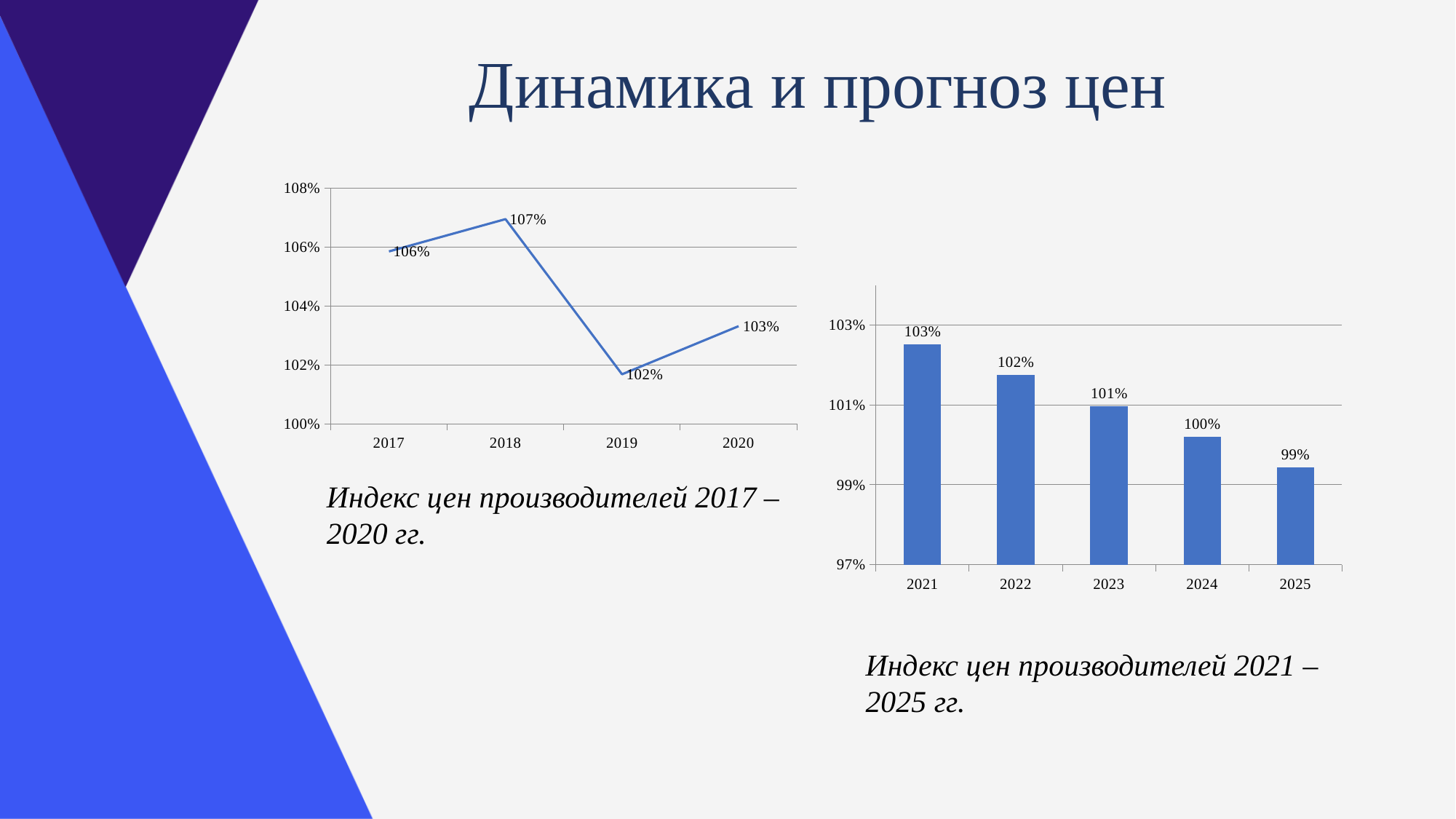
In the left chart (Индекс цен производителей 2017 – 2020 гг.), how many years are plotted? 4 In the left chart (Индекс цен производителей 2017 – 2020 гг.), what is the value for 2018? 107% In the left chart (Индекс цен производителей 2017 – 2020 гг.), which year has the lowest value? 2019 In the right chart (Индекс цен производителей 2021 – 2025 гг.), how many bars are there? 5 In the left chart (Индекс цен производителей 2017 – 2020 гг.), which year has the highest value? 2018 In the right chart (Индекс цен производителей 2021 – 2025 гг.), what kind of chart is shown? bar chart In the left chart (Индекс цен производителей 2017 – 2020 гг.), what is the value for 2019? 102% In the right chart (Индекс цен производителей 2021 – 2025 гг.), which year has the highest value? 2021 In the right chart (Индекс цен производителей 2021 – 2025 гг.), what is the value for 2023? 101% In the right chart (Индекс цен производителей 2021 – 2025 гг.), what is the value for 2025? 99% In the right chart (Индекс цен производителей 2021 – 2025 гг.), do the values rise or fall from 2021 to 2025? fall In the left chart (Индекс цен производителей 2017 – 2020 гг.), what kind of chart is shown? line chart